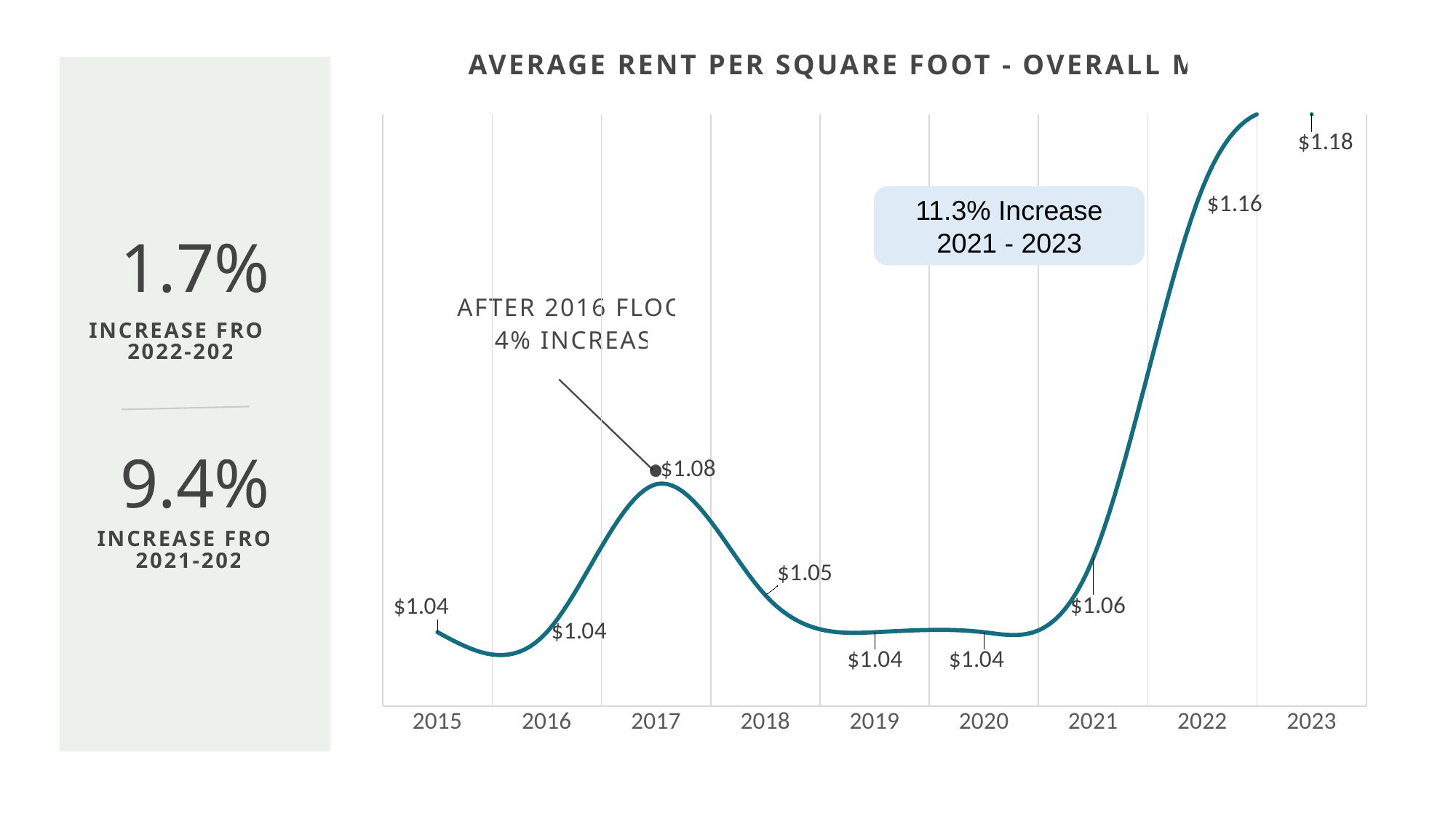
How many years are plotted on the x axis? 9 Which year has the highest average rent per square foot? 2023 What is the average rent per square foot in 2023? $1.18 What is the difference in average rent per square foot between 2017 and 2018? $0.03 What percentage increase does the callout box on the chart state for 2021 - 2023? 11.3% Which year has the larger average rent per square foot, 2017 or 2022? 2022 What is the average rent per square foot in 2018? $1.05 Do the values rise or fall from 2021 to 2023? Rise What is the average rent per square foot in 2021? $1.06 What kind of chart is shown on the slide? Line chart What is the difference in average rent per square foot between 2023 and 2021? $0.12 What is the average rent per square foot in 2017? $1.08